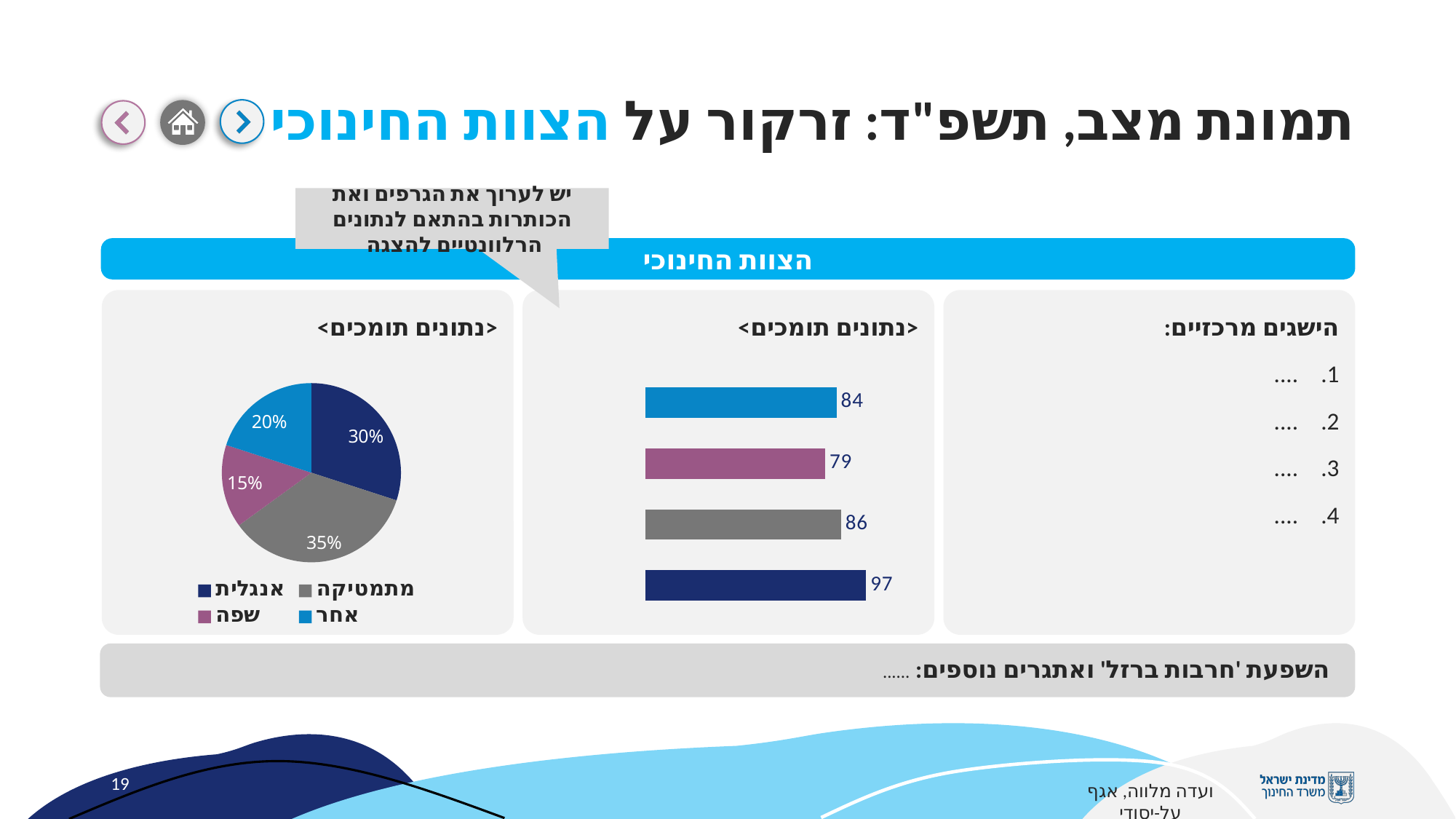
In the pie chart on the left, which category has the smallest slice? שפה What type of chart is the chart in the middle of the slide? bar chart In the pie chart on the left, which category has the largest slice? מתמטיקה In the pie chart on the left, what share does שפה have? 15% In the pie chart on the left, what share does מתמטיקה have? 35% In the pie chart on the left, how many categories does the legend list? 4 What type of chart is the chart on the left of the slide? pie chart In the bar chart in the middle, what is the difference between the bottom bar (97) and the top bar (84)? 13 In the bar chart in the middle, what is the value of the bottom (dark blue) bar? 97 In the bar chart in the middle, what is the value of the second bar from the top (purple)? 79 In the bar chart in the middle, how many bars are there? 4 In the pie chart on the left, what is the difference between the shares of אנגלית and אחר? 10%